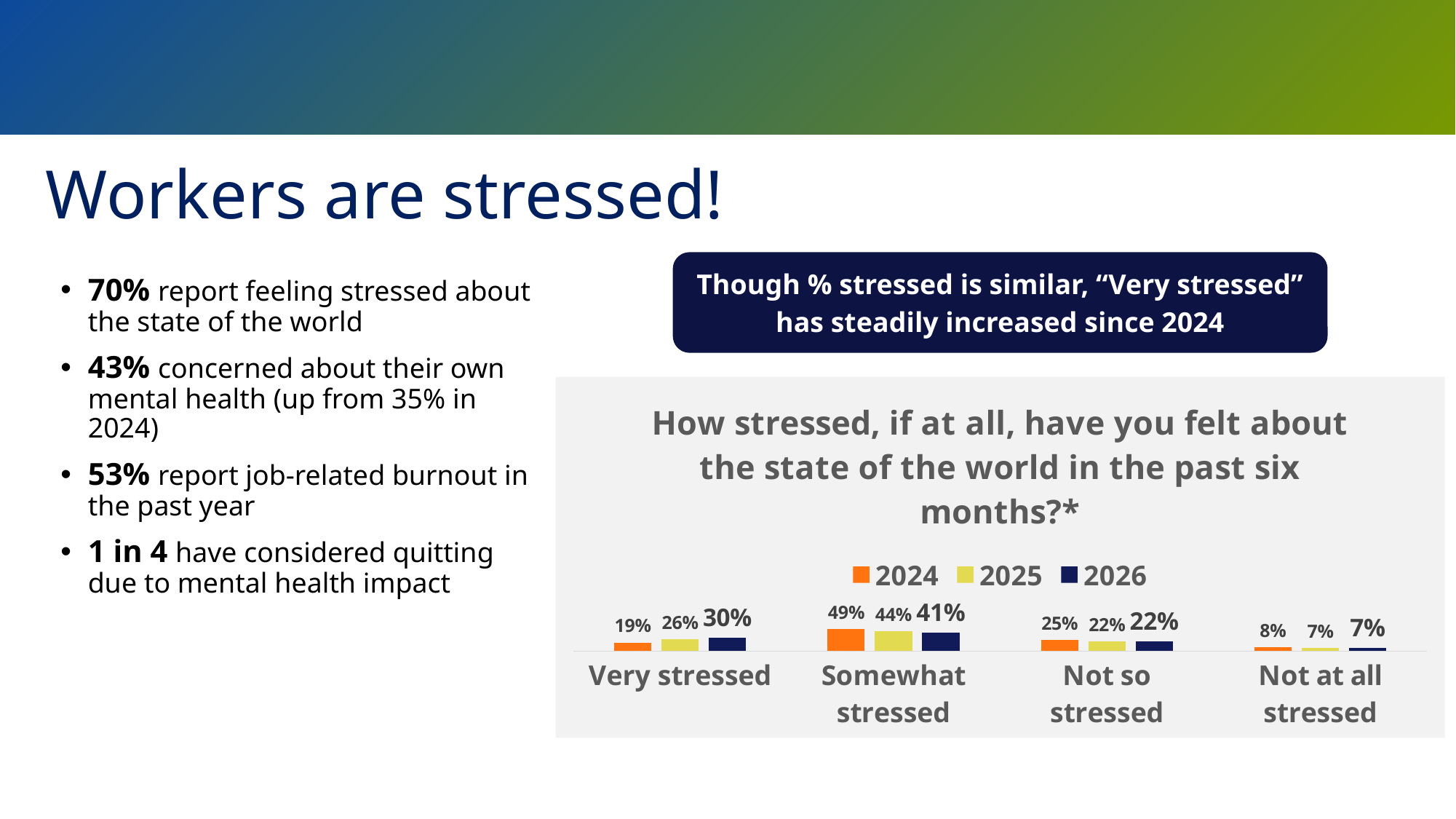
What kind of chart is shown on the slide? Bar chart What was the value for "Somewhat stressed" in 2024? 49% By how many percentage points did "Very stressed" increase from 2024 to 2026? 11 percentage points Which category had the highest value in 2024? Somewhat stressed What was the value for "Not at all stressed" in 2024? 8% What percentage of respondents were "Very stressed" in 2026? 30% Does the "Very stressed" value rise or fall from 2024 to 2026? Rises Which category had the lowest value in 2026? Not at all stressed What was the value for "Not so stressed" in 2025? 22% Which is larger: the 2025 value for "Very stressed" or the 2025 value for "Not so stressed"? Very stressed (26%) What is the difference between the 2024 and 2026 values for "Somewhat stressed"? 8 percentage points How many series does the legend list? 3